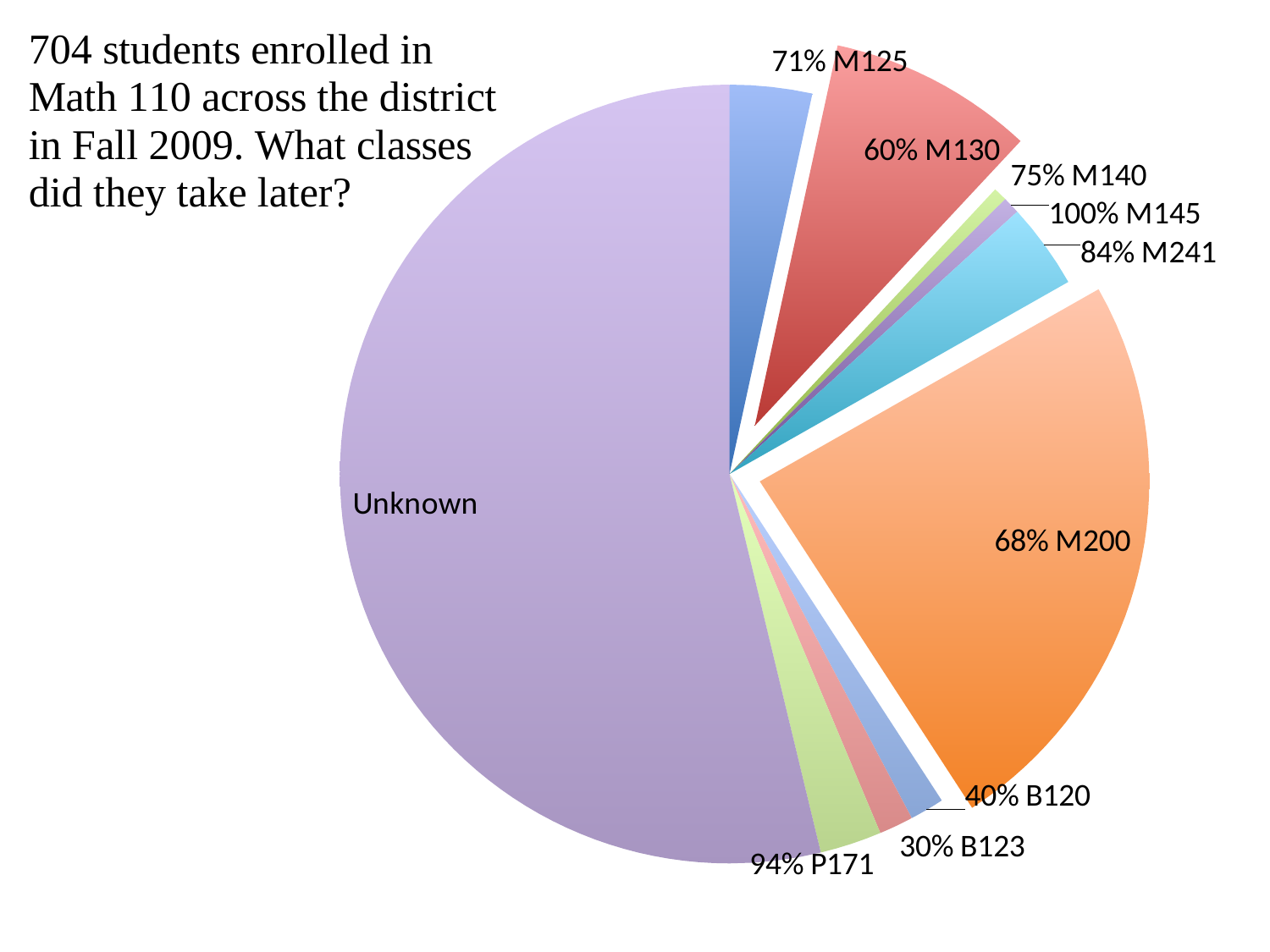
Which slice is larger, M200 or M130? M200 Which slice is larger, M125 or M140? M125 What percentage is printed next to the M200 label? 68% Which slice of the pie chart is the largest? Unknown What percentage is printed next to the M145 label? 100% How many slices does the pie chart have? 10 Which slice is larger, Unknown or M200? Unknown What kind of chart is shown on the slide? pie chart What percentage is printed next to the M241 label? 84% How many students does the slide text say enrolled in Math 110 across the district in Fall 2009? 704 What percentage is printed next to the P171 label? 94% What percentage is printed next to the B123 label? 30%